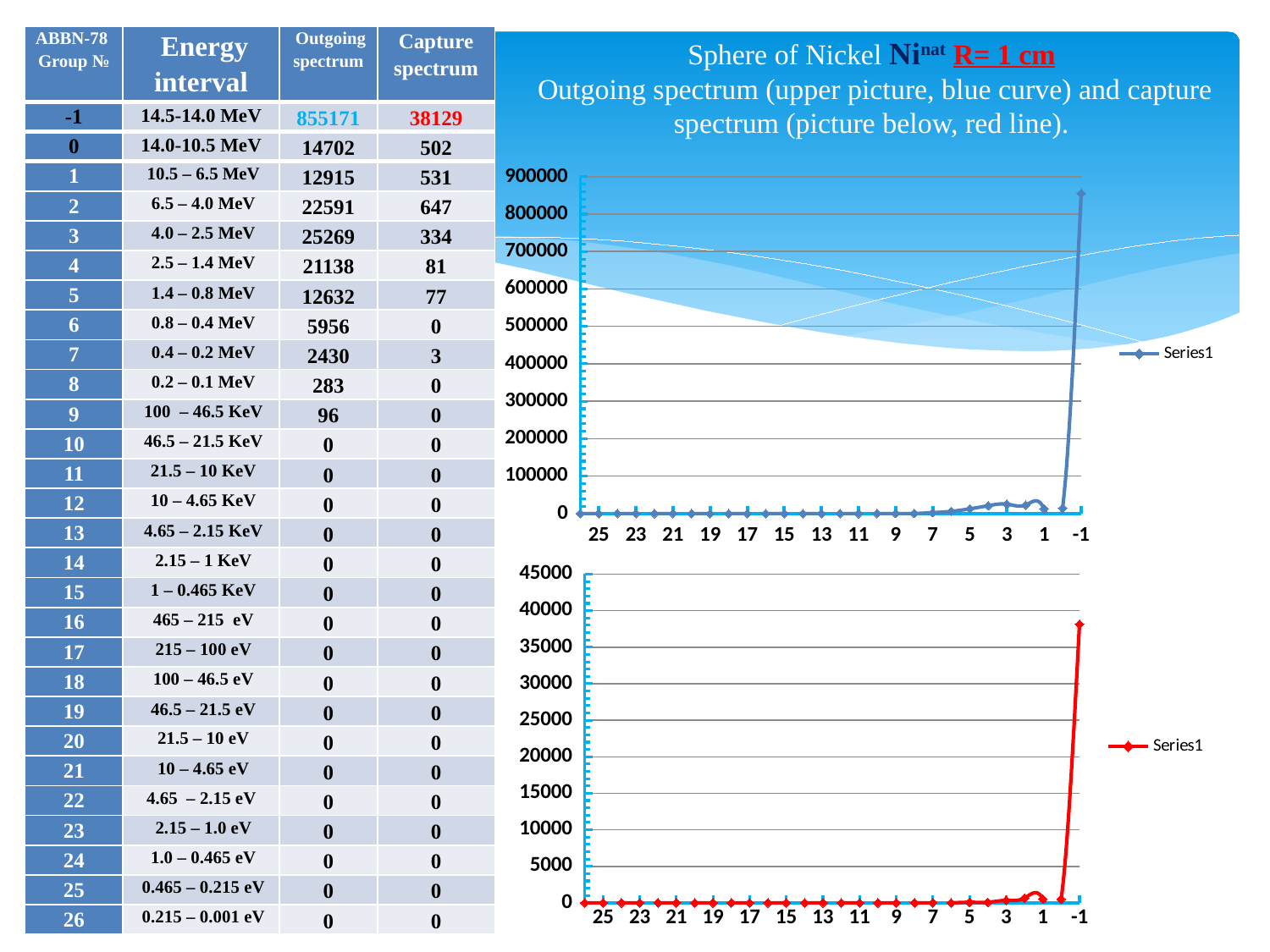
How many series does the legend of the upper chart list? 1 In the upper chart, is the value at x = -1 greater or less than 800000? greater In the upper chart, which x-axis category has the highest value? -1 What kind of chart is the upper chart on the slide? line chart According to the table on the slide, what is the capture spectrum value for ABBN-78 group -1, the peak point of the lower chart? 38129 What is the name of the series shown in the legend of the lower chart? Series1 In the lower chart, which x-axis category has the highest value? -1 In the upper chart, do the values generally rise or fall moving along the x axis from 25 toward -1? rise In the lower chart, is the value at x = -1 greater or less than 35000? greater According to the table on the slide, what is the outgoing spectrum value for ABBN-78 group -1, the peak point of the upper chart? 855171 What colour is the line in the lower chart? red In the upper chart, is the value at x = 13 greater or less than 100000? less